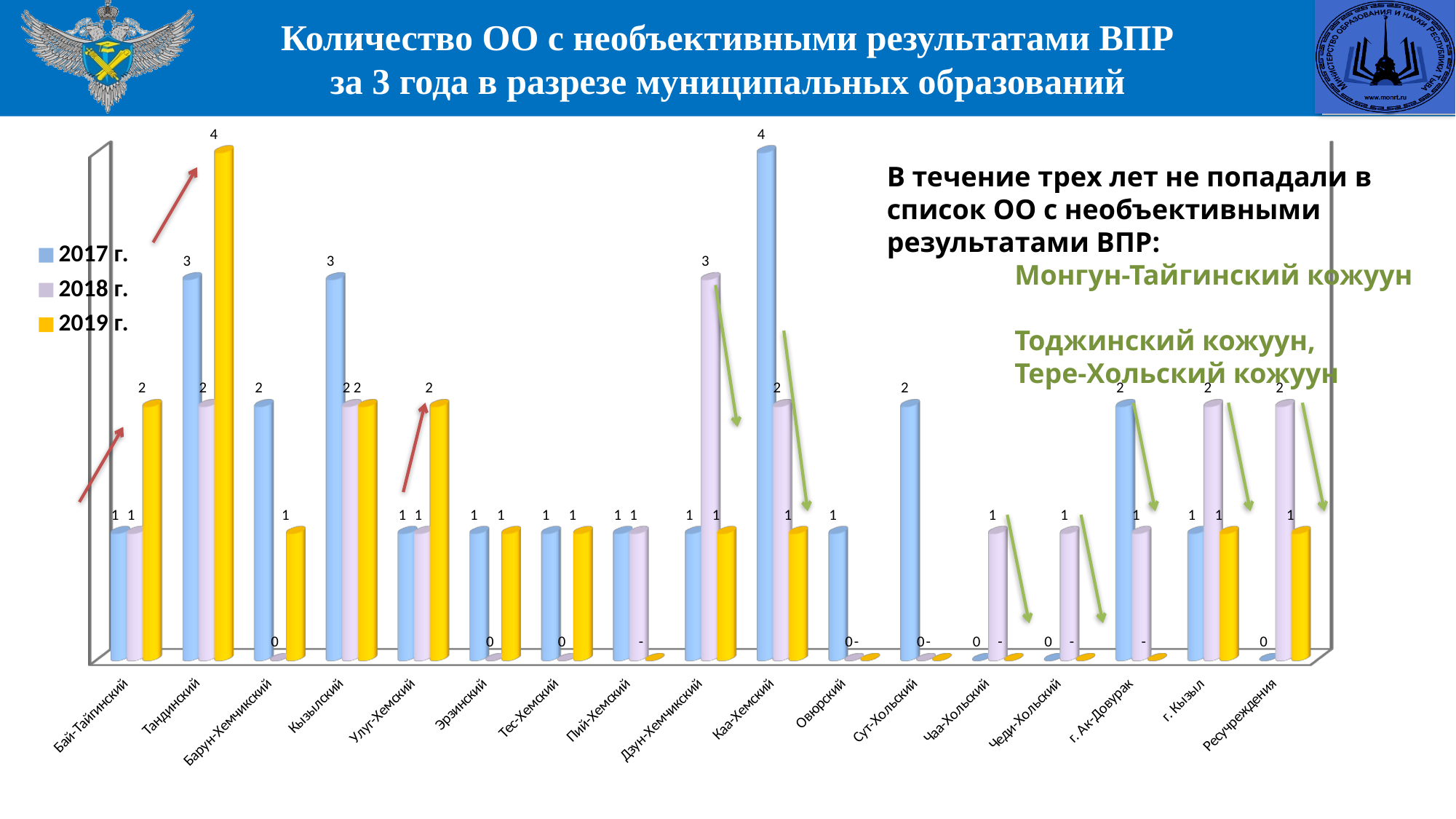
Which municipality has the highest value for 2017 г.? Каа-Хемский Which is larger for Кызылский: the 2017 г. value or the 2019 г. value? 2017 г. Which municipality has the highest value for 2019 г.? Тандинский What type of chart is shown on the slide? bar chart What is the value for Барун-Хемчикский in 2018 г.? 0 What is the difference between the 2017 г. and 2019 г. values for Каа-Хемский? 3 How many municipalities (categories) are shown on the x axis? 17 What is the value for Тандинский in 2019 г.? 4 What is the value for Каа-Хемский in 2017 г.? 4 How many series does the legend list? 3 What is the value for Дзун-Хемчикский in 2018 г.? 3 Which colour represents the 2019 г. series in the legend? yellow